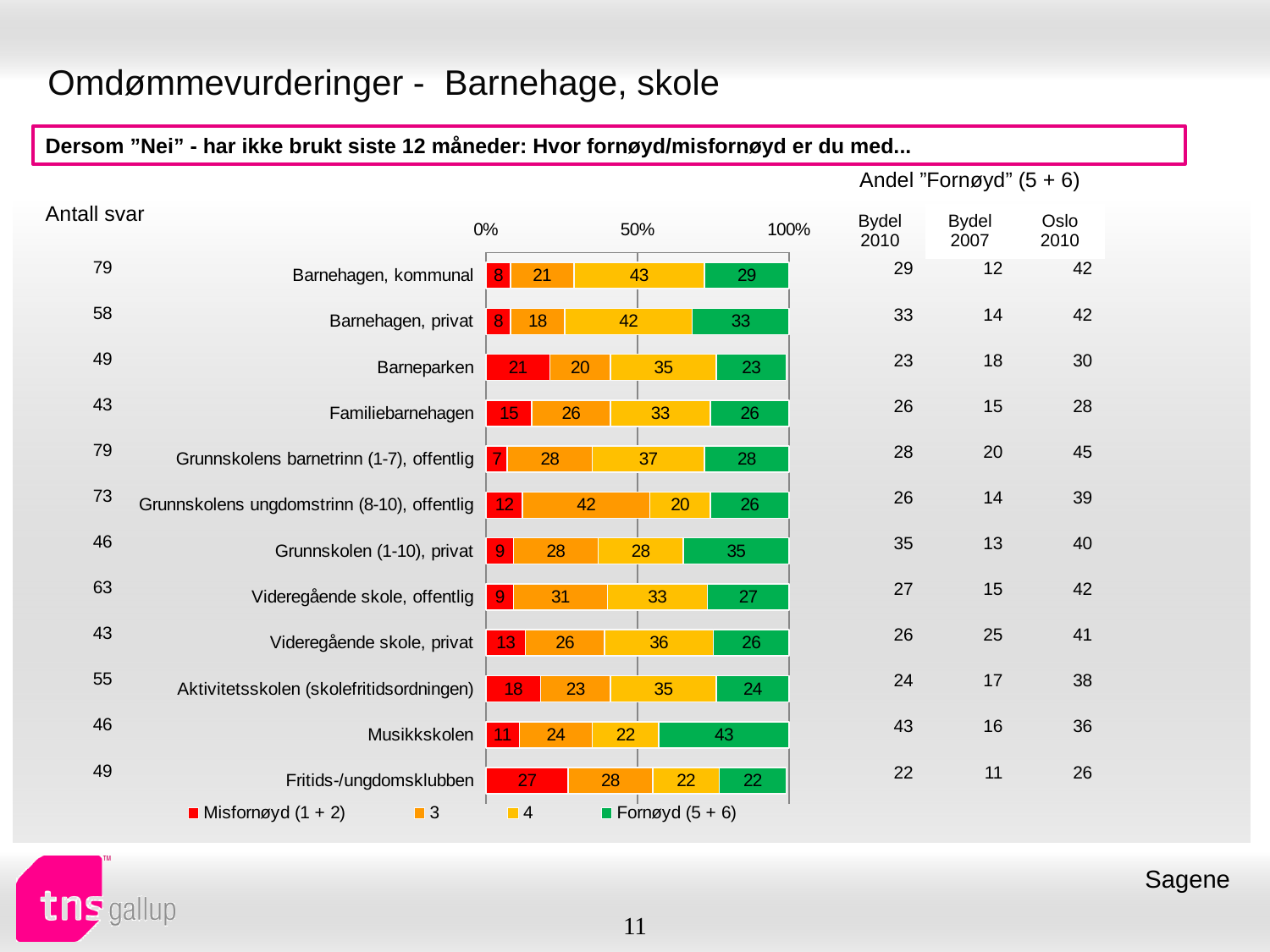
How many series does the legend list? 4 What is the Misfornøyd (1 + 2) value for Fritids-/ungdomsklubben? 27 How many categories are shown in the chart? 12 What percentage of respondents are Fornøyd (5 + 6) with Musikkskolen? 43 Which has a larger Misfornøyd (1 + 2) value: Barneparken or Familiebarnehagen? Barneparken Which category has the highest Misfornøyd (1 + 2) value? Fritids-/ungdomsklubben Which category has the lowest Fornøyd (5 + 6) value? Fritids-/ungdomsklubben What type of chart is shown on the slide? Stacked bar chart What is the value of series 4 for Barnehagen, kommunal? 43 What is the difference between the Fornøyd (5 + 6) values for Grunnskolen (1-10), privat and Videregående skole, offentlig? 8 Which category has the highest Fornøyd (5 + 6) value? Musikkskolen What is the value of series 3 for Grunnskolens ungdomstrinn (8-10), offentlig? 42